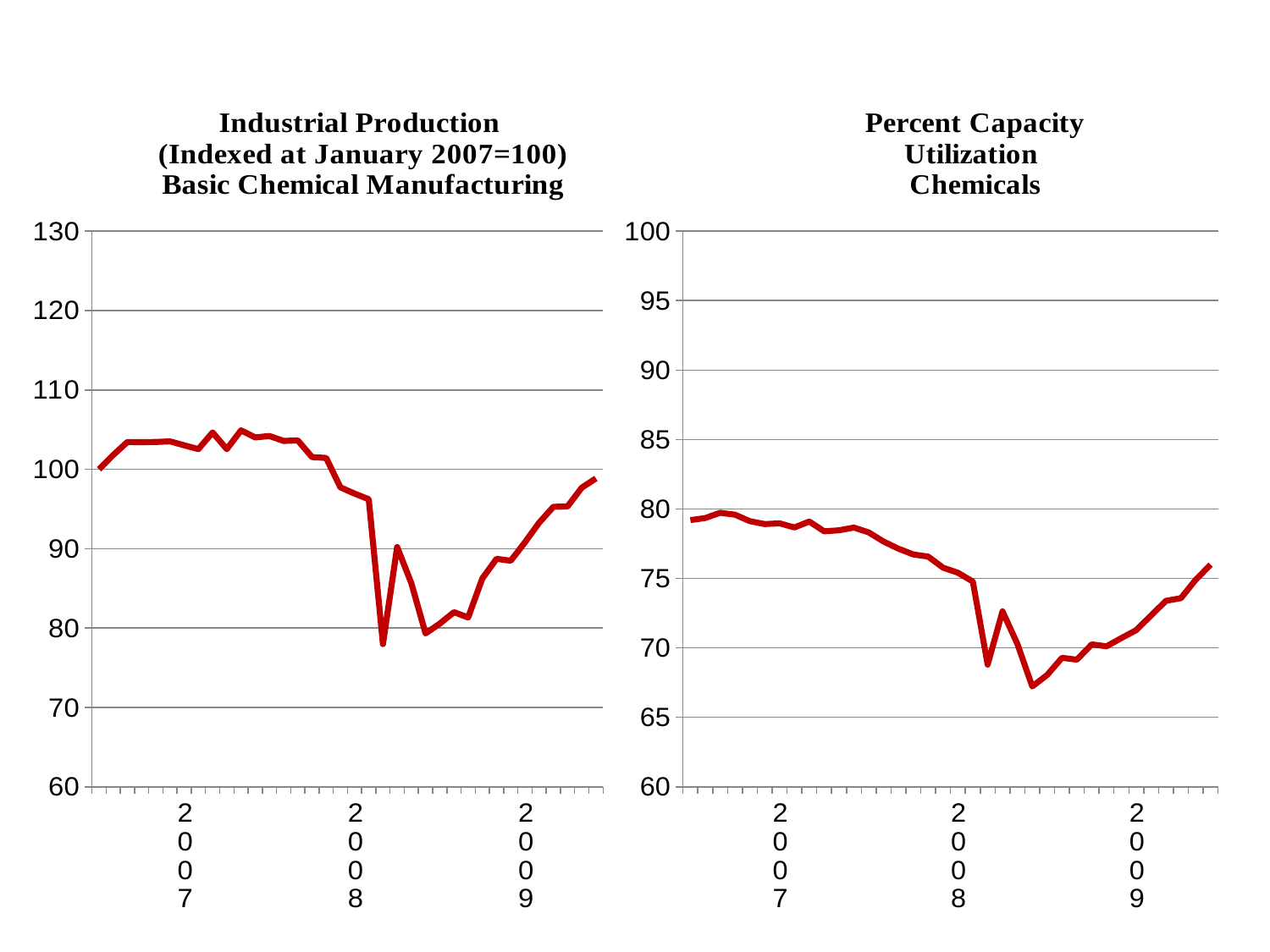
In the 'Percent Capacity Utilization Chemicals' chart, does the line rise or fall between the start of 2007 and the start of 2009? fall What are the years labelled on the x axis of the 'Percent Capacity Utilization Chemicals' chart? 2007, 2008, 2009 In the 'Industrial Production' chart, does the line rise or fall from its lowest point in 2008 to the end of the series in 2009? rise In the 'Industrial Production' chart, is the last point of the line greater or less than 100? less In the 'Percent Capacity Utilization Chemicals' chart, is the lowest point of the line greater or less than 70? less How many charts are shown on the slide? 2 In the 'Industrial Production' chart, is the highest point of the line greater or less than 100? greater What kind of chart is the 'Industrial Production' chart on the left? line chart What kind of chart is the 'Percent Capacity Utilization Chemicals' chart on the right? line chart In the 'Industrial Production' chart, what is the value of the first point of the line, at January 2007? 100